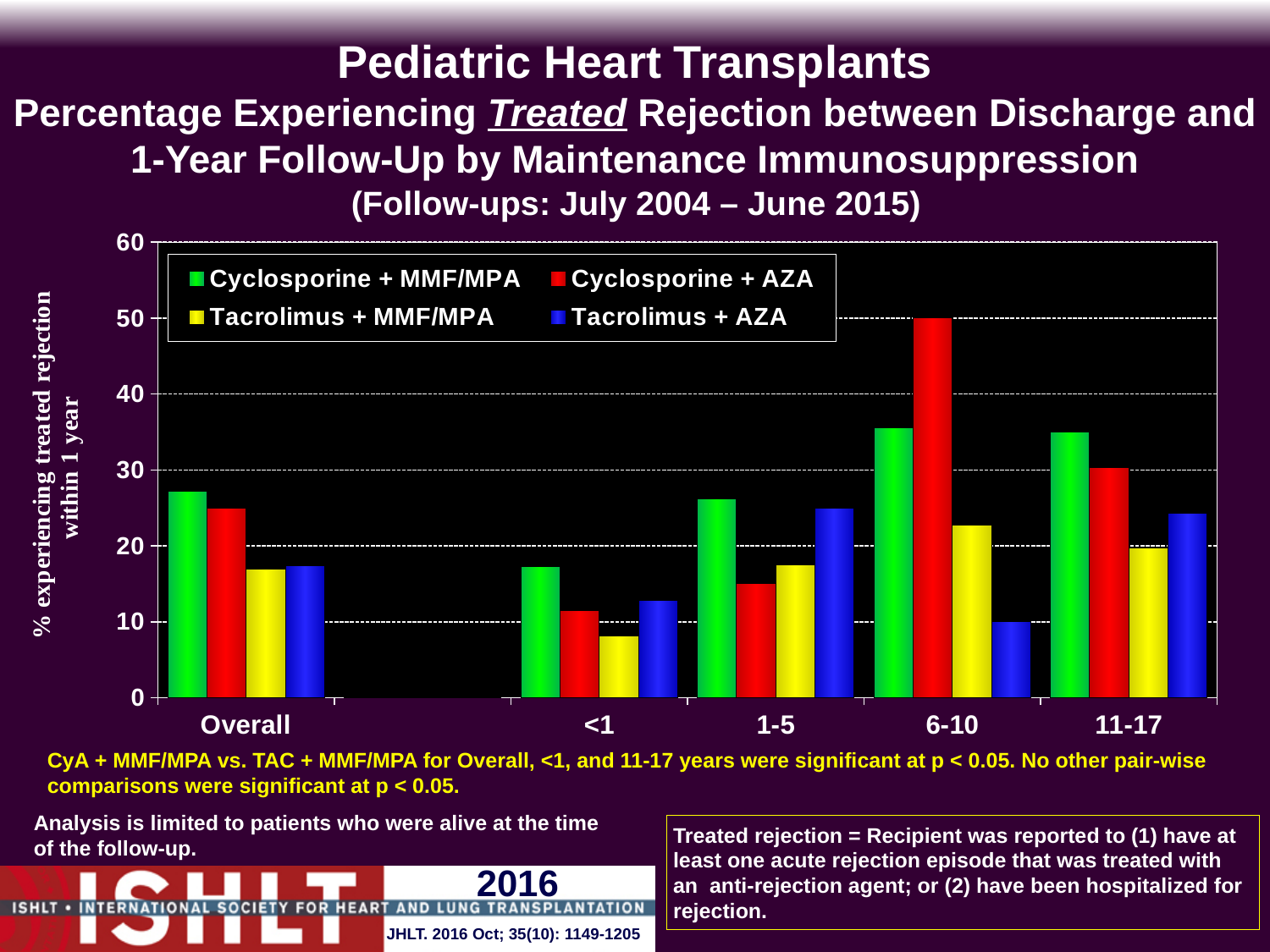
How many series does the legend list? 4 Is the value for Tacrolimus + MMF/MPA in the <1 age group greater or less than 10? less Is the value for Cyclosporine + MMF/MPA in the 11-17 age group greater or less than 30? greater In the 6-10 age group, which is larger: Cyclosporine + AZA or Cyclosporine + MMF/MPA? Cyclosporine + AZA What follow-up period is stated in the chart title? July 2004 – June 2015 In the <1 age group, which is larger: Cyclosporine + MMF/MPA or Tacrolimus + MMF/MPA? Cyclosporine + MMF/MPA Which age group has the lowest Tacrolimus + MMF/MPA bar? <1 How many categories are shown along the x axis? 5 Is the value for Tacrolimus + AZA in the 6-10 age group greater or less than 20? less Which age group has the highest Cyclosporine + AZA bar? 6-10 What kind of chart is shown on the slide? Bar chart